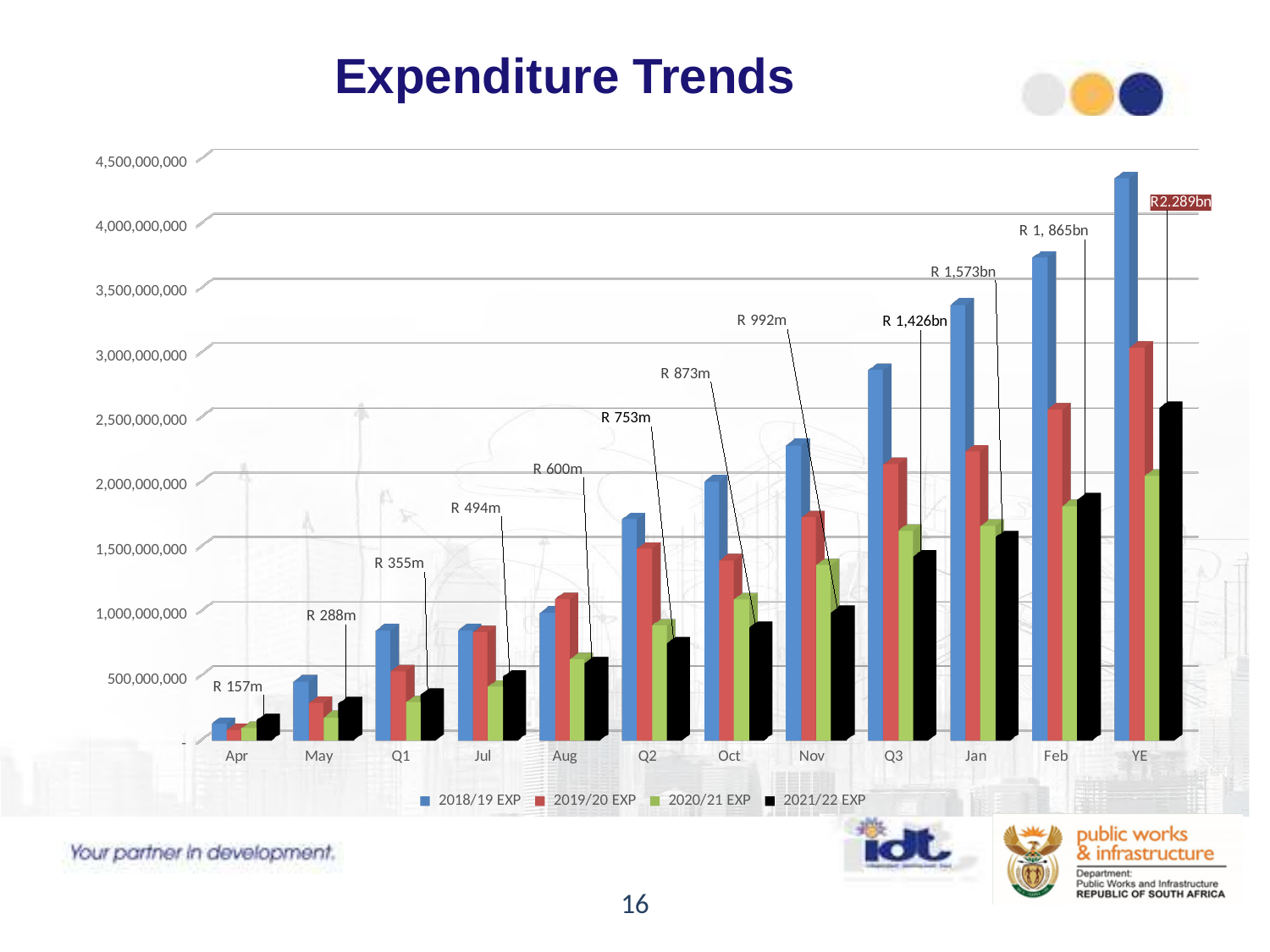
Which category has the lowest labelled value for 2021/22 EXP? Apr At YE, which series has the larger value: 2018/19 EXP or 2021/22 EXP? 2018/19 EXP What is the labelled value for 2021/22 EXP in Nov? R 992m Do the 2018/19 EXP values rise or fall from Apr to YE? rise What is the labelled value for 2021/22 EXP in Apr? R 157m What is the difference between the 2021/22 EXP values for May and Apr? R 130m What is the labelled value for 2021/22 EXP in Q2? R 753m What is the labelled value for 2021/22 EXP at YE? R2.289bn Is the value for 2018/19 EXP at YE greater or less than 4,000,000,000? greater What kind of chart is shown on the slide? bar chart How many categories are shown along the x axis? 12 How many series does the legend list? 4